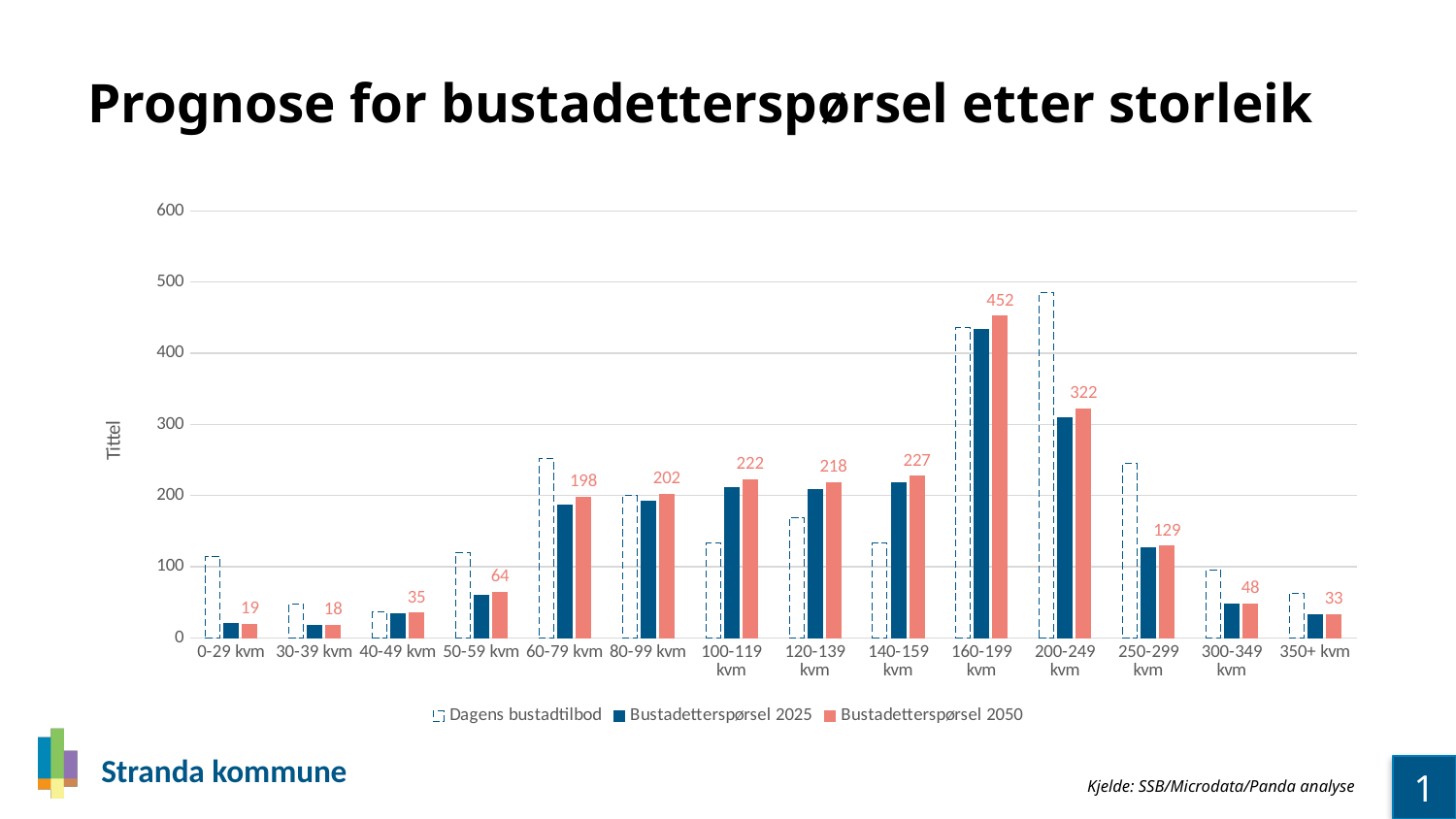
Which is larger, the Bustadetterspørsel 2050 value for 120-139 kvm or for 140-159 kvm? 140-159 kvm What is the difference between the Bustadetterspørsel 2050 values for 160-199 kvm and 200-249 kvm? 130 Which size category has the lowest Bustadetterspørsel 2050 value? 30-39 kvm What is the Bustadetterspørsel 2050 value for 250-299 kvm? 129 Is the Bustadetterspørsel 2025 value for 60-79 kvm greater or less than 200? less Which size category has the highest Bustadetterspørsel 2050 value? 160-199 kvm How many size categories are shown on the x axis? 14 What is the Bustadetterspørsel 2050 value for 50-59 kvm? 64 How many series does the legend list? 3 Is the Dagens bustadtilbod value for 200-249 kvm greater or less than 400? greater What is the Bustadetterspørsel 2050 value for 160-199 kvm? 452 What type of chart is shown on the slide? Bar chart